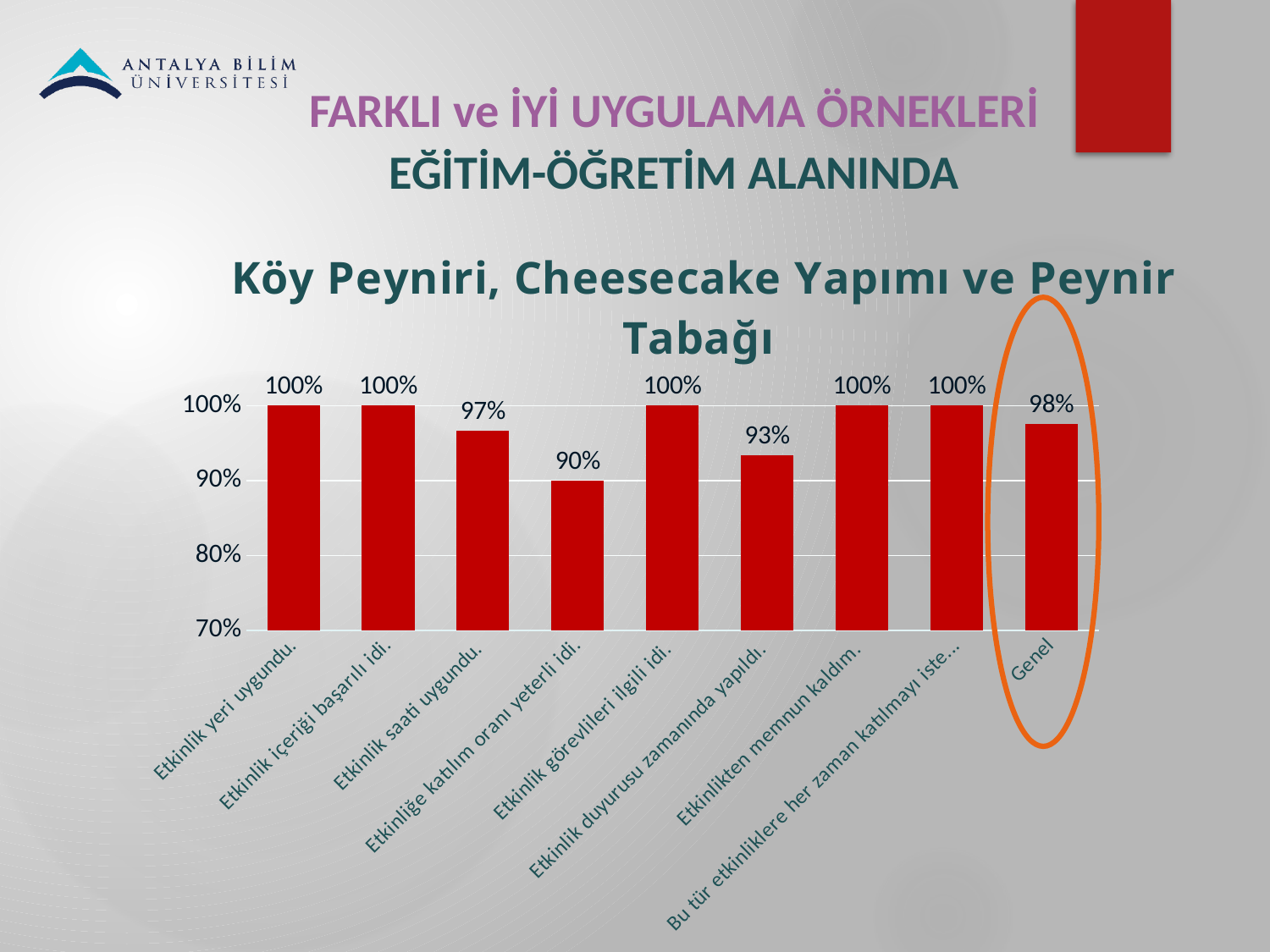
What is the difference between the values for "Genel" and "Etkinlik duyurusu zamanında yapıldı."? 5% What is the value for "Etkinlik saati uygundu."? 97% Which is larger, the value for "Etkinlik saati uygundu." or the value for "Etkinlik duyurusu zamanında yapıldı."? Etkinlik saati uygundu. What is the difference between the values for "Etkinlik saati uygundu." and "Etkinliğe katılım oranı yeterli idi."? 7% Which category has the lowest value? Etkinliğe katılım oranı yeterli idi. What is the value for "Genel"? 98% What is the value for "Etkinliğe katılım oranı yeterli idi."? 90% What is the value for "Etkinlikten memnun kaldım."? 100% What is the title of the chart? Köy Peyniri, Cheesecake Yapımı ve Peynir Tabağı How many categories are shown on the x axis? 9 What kind of chart is shown on the slide? Bar chart What is the value for "Etkinlik duyurusu zamanında yapıldı."? 93%